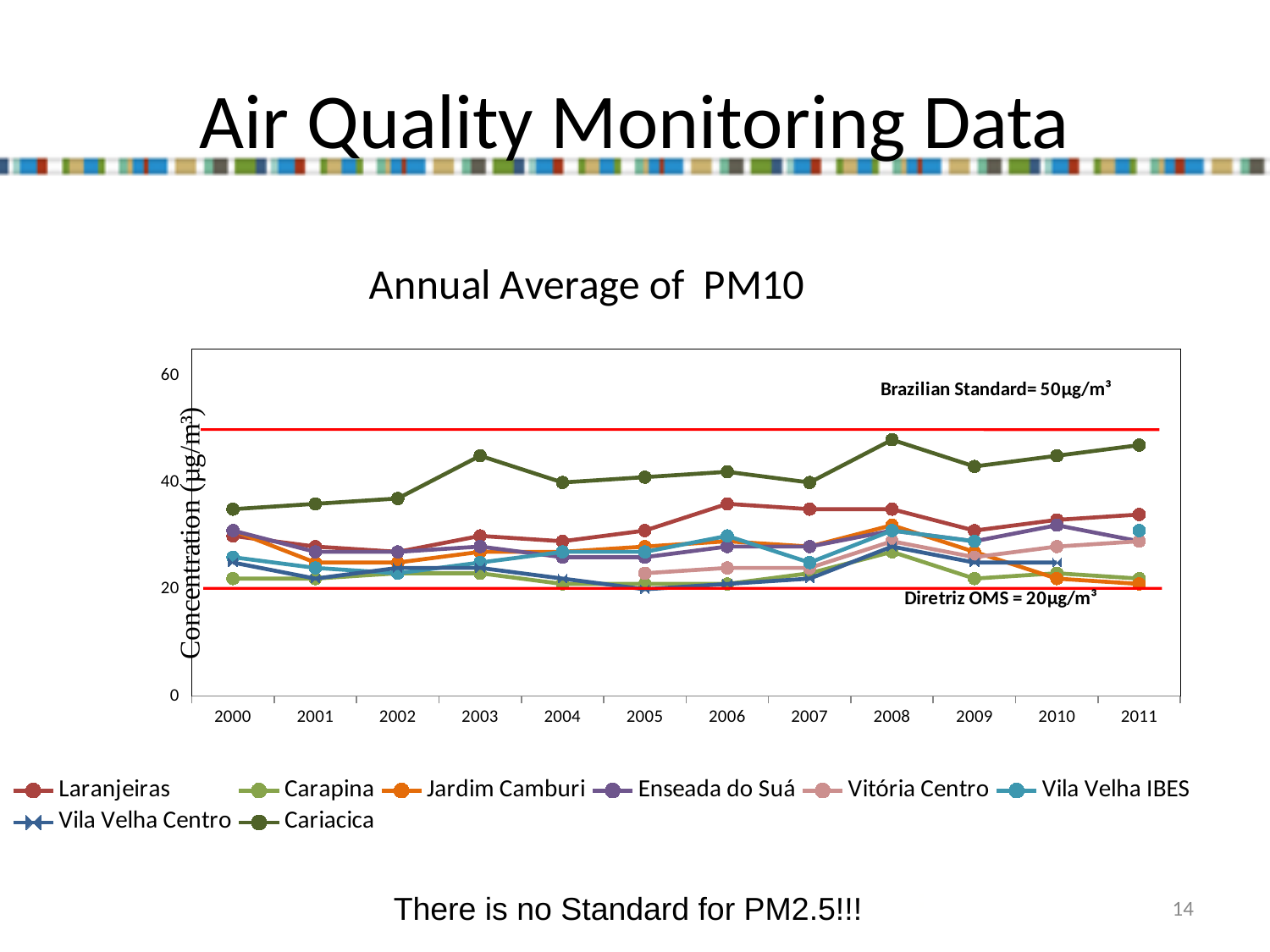
What kind of chart is shown on the slide? line chart Is the value for Cariacica in 2000 greater or less than 40? less Which monitoring station has the highest PM10 concentration across the years shown? Cariacica Is the value for Cariacica in 2008 greater or less than 40? greater Is the value for Vila Velha IBES in 2011 greater or less than 20? greater What is the title of the chart? Annual Average of PM10 In 2008, which is larger: the value for Cariacica or the value for Laranjeiras? Cariacica How many series does the legend list? 8 Does the Cariacica series generally rise or fall from 2000 to 2011? rise What value is given for the Brazilian Standard on the chart? 50µg/m³ How many years are shown along the x axis? 12